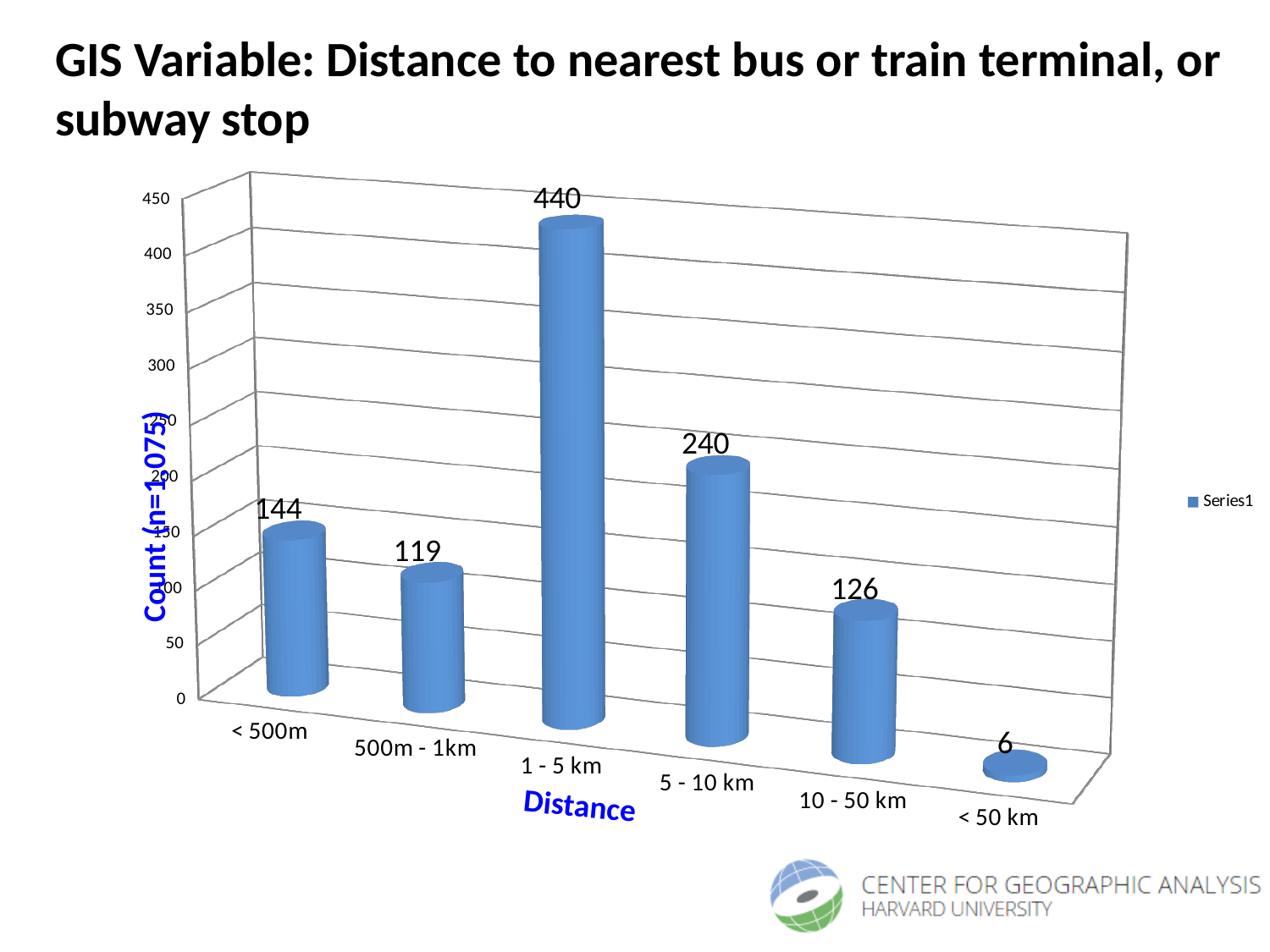
What is the count for the 10 - 50 km distance category? 126 What is the label of the y axis? Count (n=1,075) What is the count for the 1 - 5 km distance category? 440 What is the difference between the counts for < 500m and 500m - 1km? 25 What kind of chart is shown on the slide? bar chart Which distance category has the highest count? 1 - 5 km Which distance category has the lowest count? < 50 km Which has a larger count, 5 - 10 km or 10 - 50 km? 5 - 10 km What is the difference between the counts for 1 - 5 km and 5 - 10 km? 200 How many distance categories are shown on the x axis? 6 How many series does the legend list? 1 What is the count for the < 500m distance category? 144